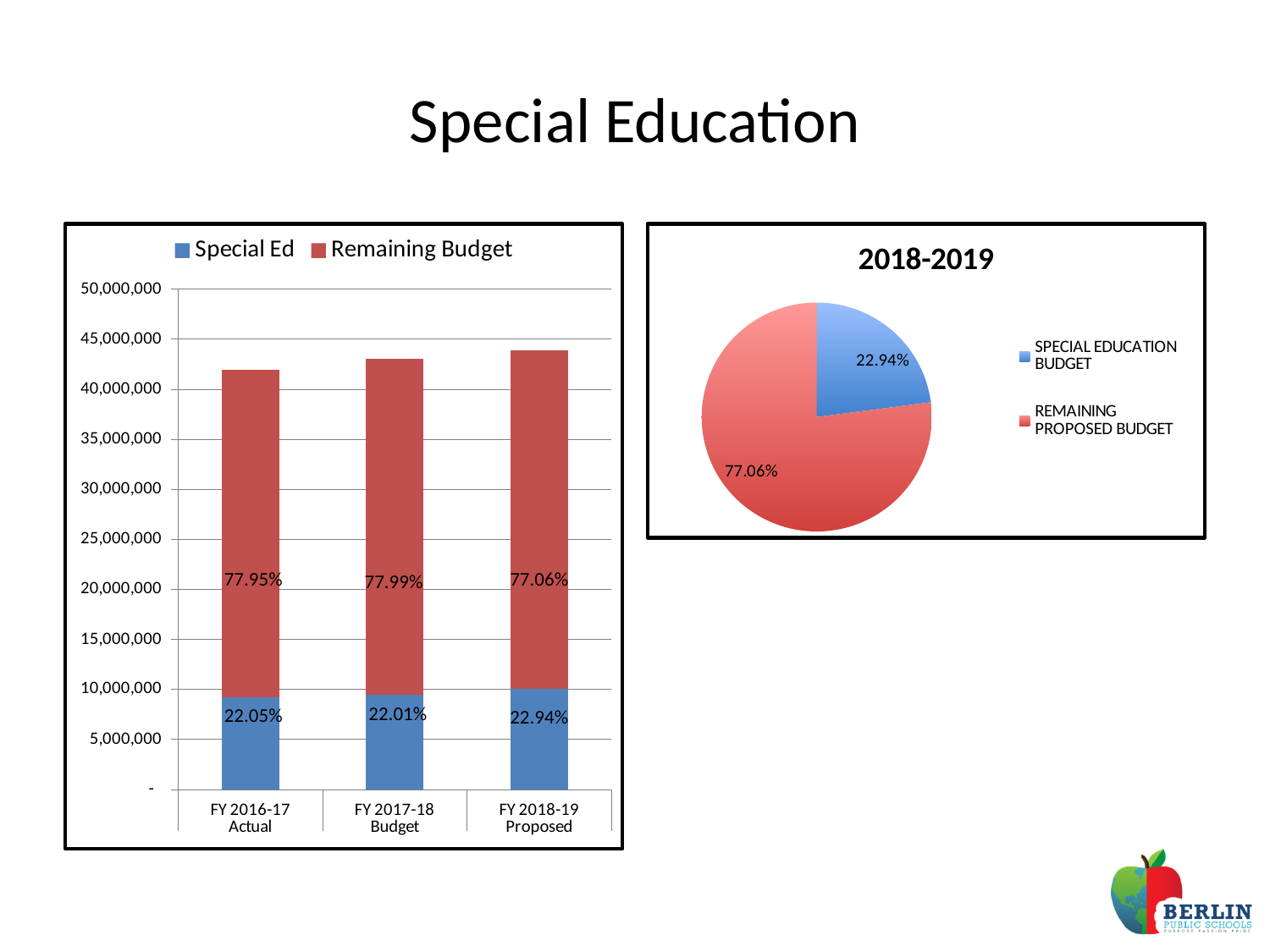
In the left bar chart, is the Remaining Budget percentage larger for FY 2017-18 Budget or FY 2016-17 Actual? FY 2017-18 Budget In the left bar chart, do the total bar heights rise or fall from FY 2016-17 Actual to FY 2018-19 Proposed? Rise In the left bar chart, what percentage label is shown for Remaining Budget in FY 2016-17 Actual? 77.95% In the left bar chart, is the total height of the FY 2016-17 Actual bar greater or less than 45,000,000? less What is the title of the pie chart on the right of the slide? 2018-2019 In the 2018-2019 pie chart, what share is labelled for the Special Education Budget slice? 22.94% In the left bar chart, which fiscal year has the highest Special Ed percentage? FY 2018-19 Proposed In the left bar chart, which fiscal year has the lowest Remaining Budget percentage? FY 2018-19 Proposed How many series does the legend of the left bar chart list? 2 In the left bar chart, what percentage label is shown for Special Ed in FY 2017-18 Budget? 22.01% What kind of chart is the chart on the left of the slide? Stacked bar chart How many fiscal year categories are shown in the left bar chart? 3